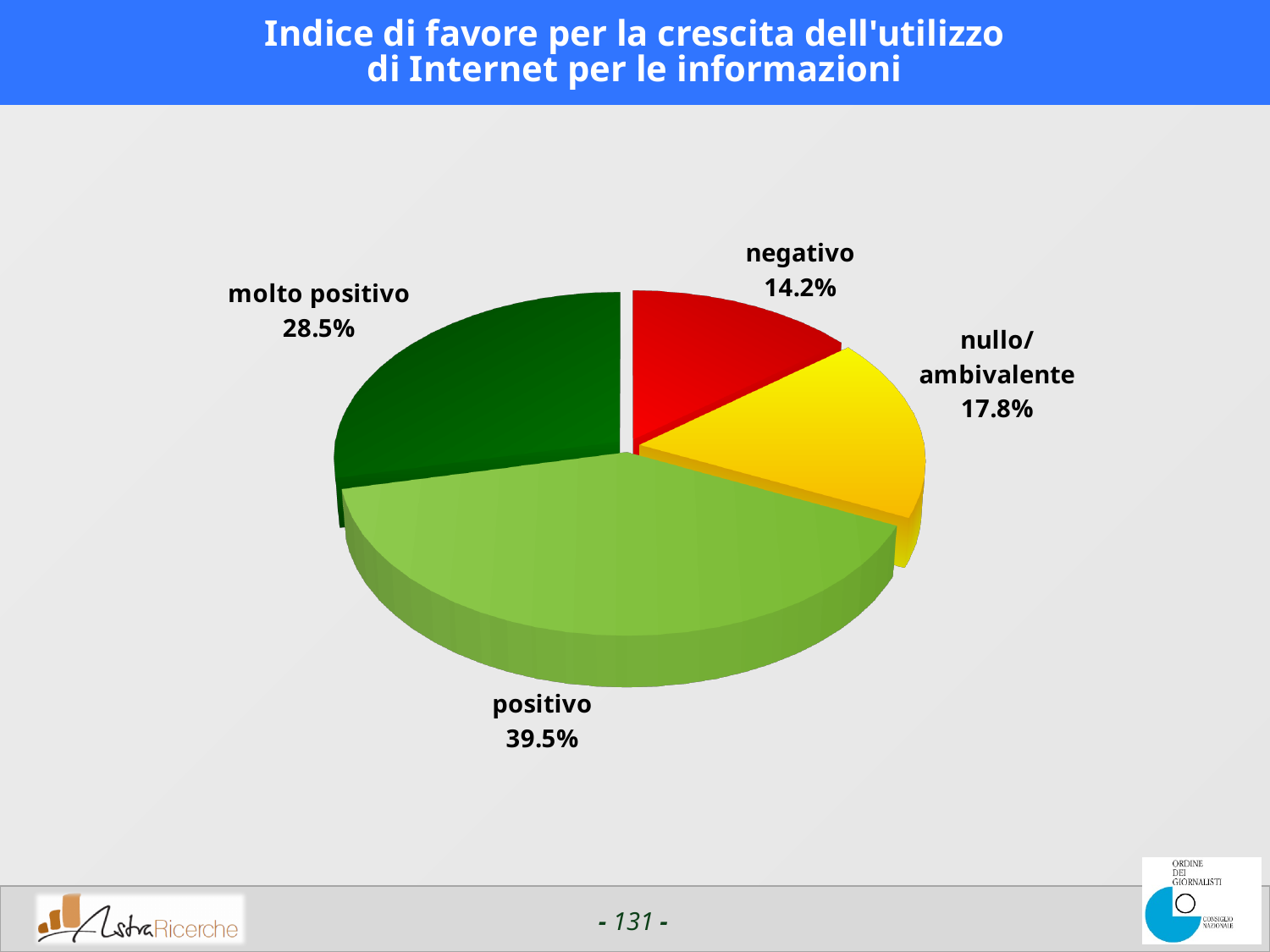
What kind of chart is shown on the slide? pie chart Which category has the largest share of the pie? positivo What is the value for "positivo"? 39.5% What is the combined share of "molto positivo" and "positivo"? 68.0% What is the difference between the values for "positivo" and "molto positivo"? 11.0% Which is larger, the value for "nullo/ambivalente" or the value for "negativo"? nullo/ambivalente Which category has the smallest share of the pie? negativo What is the value for "nullo/ambivalente"? 17.8% How many categories (slices) does the pie chart have? 4 What is the value for "molto positivo"? 28.5% What is the value for "negativo"? 14.2% What is the title of the chart? Indice di favore per la crescita dell'utilizzo di Internet per le informazioni